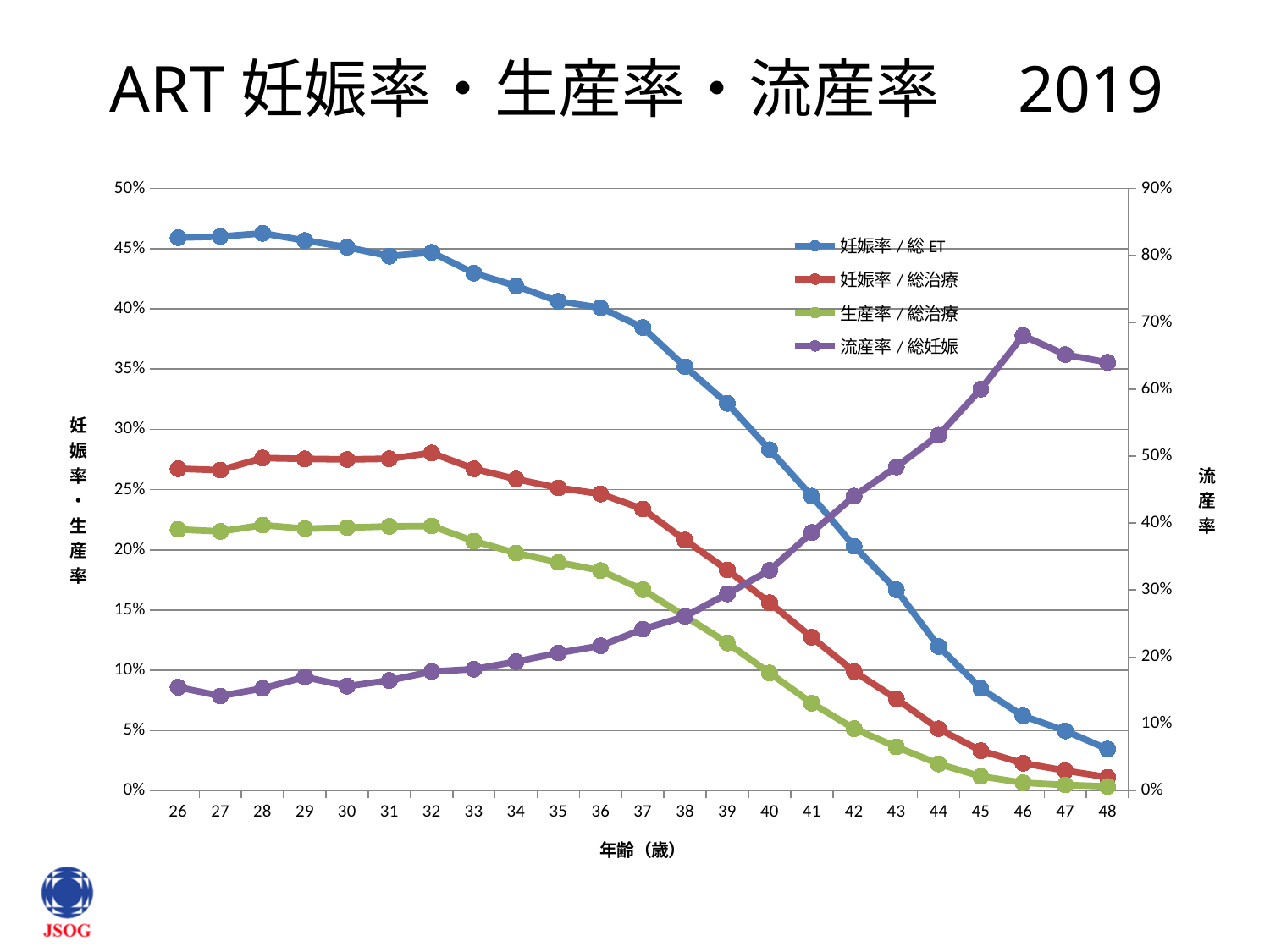
Is the value for 妊娠率 / 総 ET at age 40 greater or less than 30%? less How many series does the legend list? 4 At which age is 生産率 / 総治療 lowest? 48 Is the value for 流産率 / 総妊娠 at age 46 greater or less than 60% on the right axis? greater Is the value for 流産率 / 総妊娠 at age 26 greater or less than 20% on the right axis? less What kind of chart is shown on the slide? Line chart At age 40, which is higher: 妊娠率 / 総 ET or 妊娠率 / 総治療? 妊娠率 / 総 ET At which age does 流産率 / 総妊娠 reach its highest value? 46 Does 妊娠率 / 総 ET rise or fall as age increases from 26 to 48? fall How many age categories are plotted along the x axis? 23